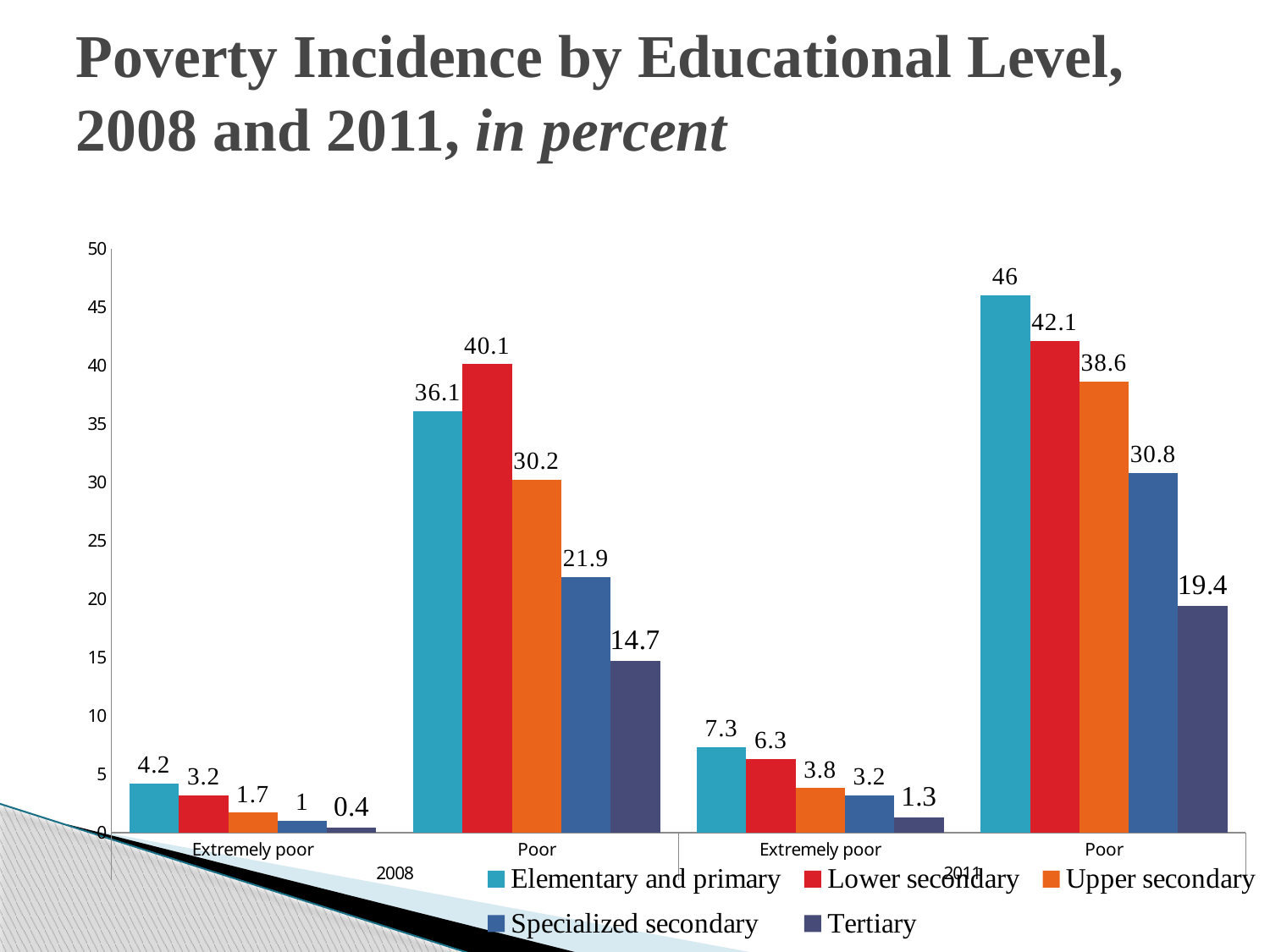
What is the value for Elementary and primary in the Poor category for 2011? 46 What is the value for Tertiary in the Extremely poor category for 2008? 0.4 Which educational level has the highest value in the Poor category for 2008? Lower secondary What is the value for Upper secondary in the Poor category for 2008? 30.2 How many series does the legend list? 5 Which colour represents Lower secondary in the legend? Red Which is larger: the Specialized secondary value for Poor in 2008 or for Poor in 2011? Poor in 2011 Which educational level has the lowest value in the Extremely poor category for 2011? Tertiary How many category groups are shown along the x axis? 4 Is the value for Tertiary in the Poor category for 2011 greater or less than 20? less What is the difference between the Lower secondary values for Poor in 2011 and Poor in 2008? 2 What kind of chart is shown on the slide? Bar chart